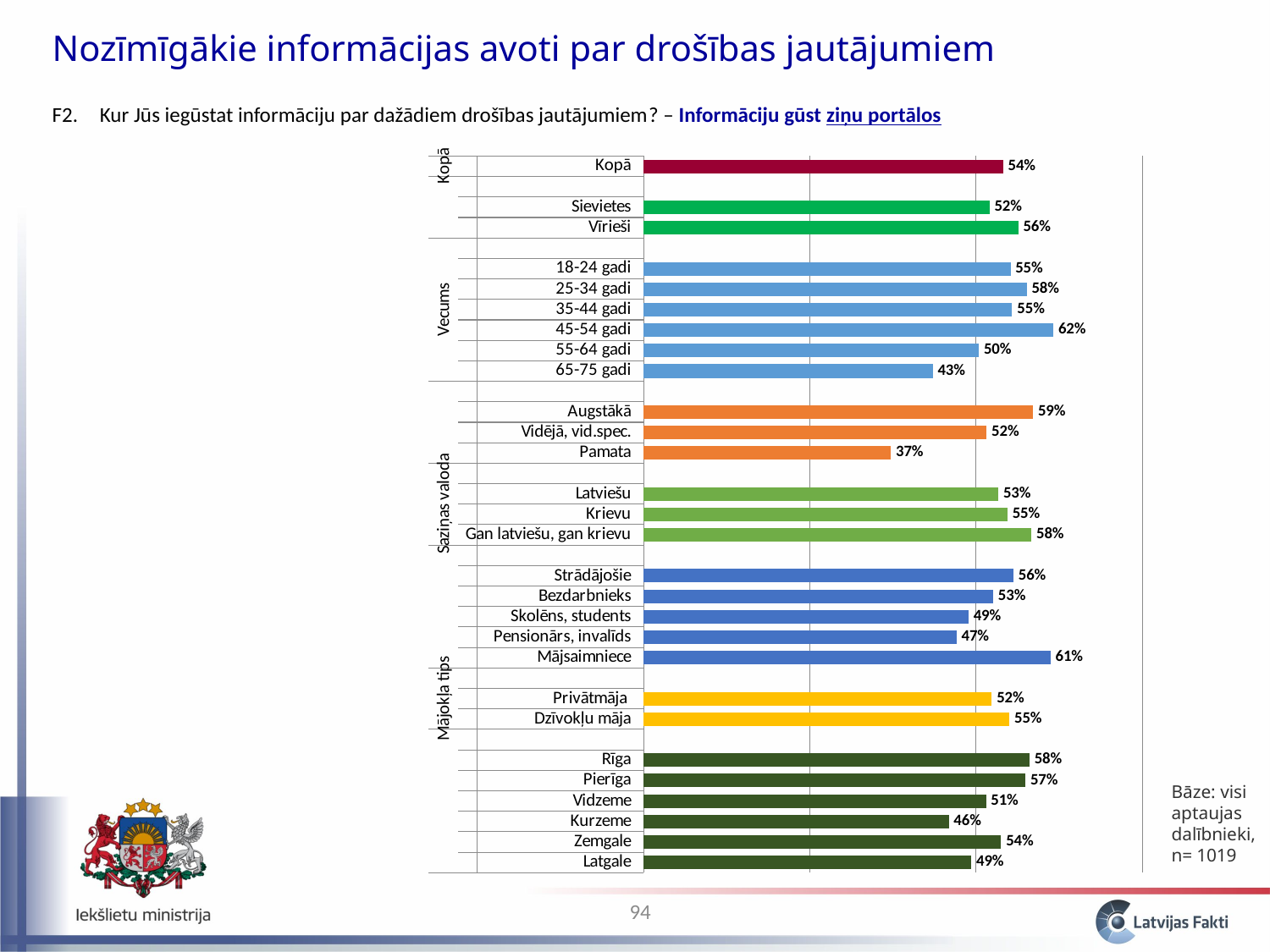
Which is larger, the value for Privātmāja or the value for Dzīvokļu māja? Dzīvokļu māja Which category has the highest value in the chart? 45-54 gadi What is the difference between the values for Augstākā and Pamata? 22% What is the value for Kopā? 54% What is the value for 65-75 gadi? 43% Among the regions (Rīga, Pierīga, Vidzeme, Kurzeme, Zemgale, Latgale), which has the lowest value? Kurzeme What is the value for Mājsaimniece? 61% Which category has the lowest value in the chart? Pamata What is the difference between the values for Vīrieši and Sievietes? 4% What kind of chart is shown on the slide? Bar chart Which is larger, the value for Rīga or the value for Kurzeme? Rīga How many categories (bars) are plotted in the chart? 28